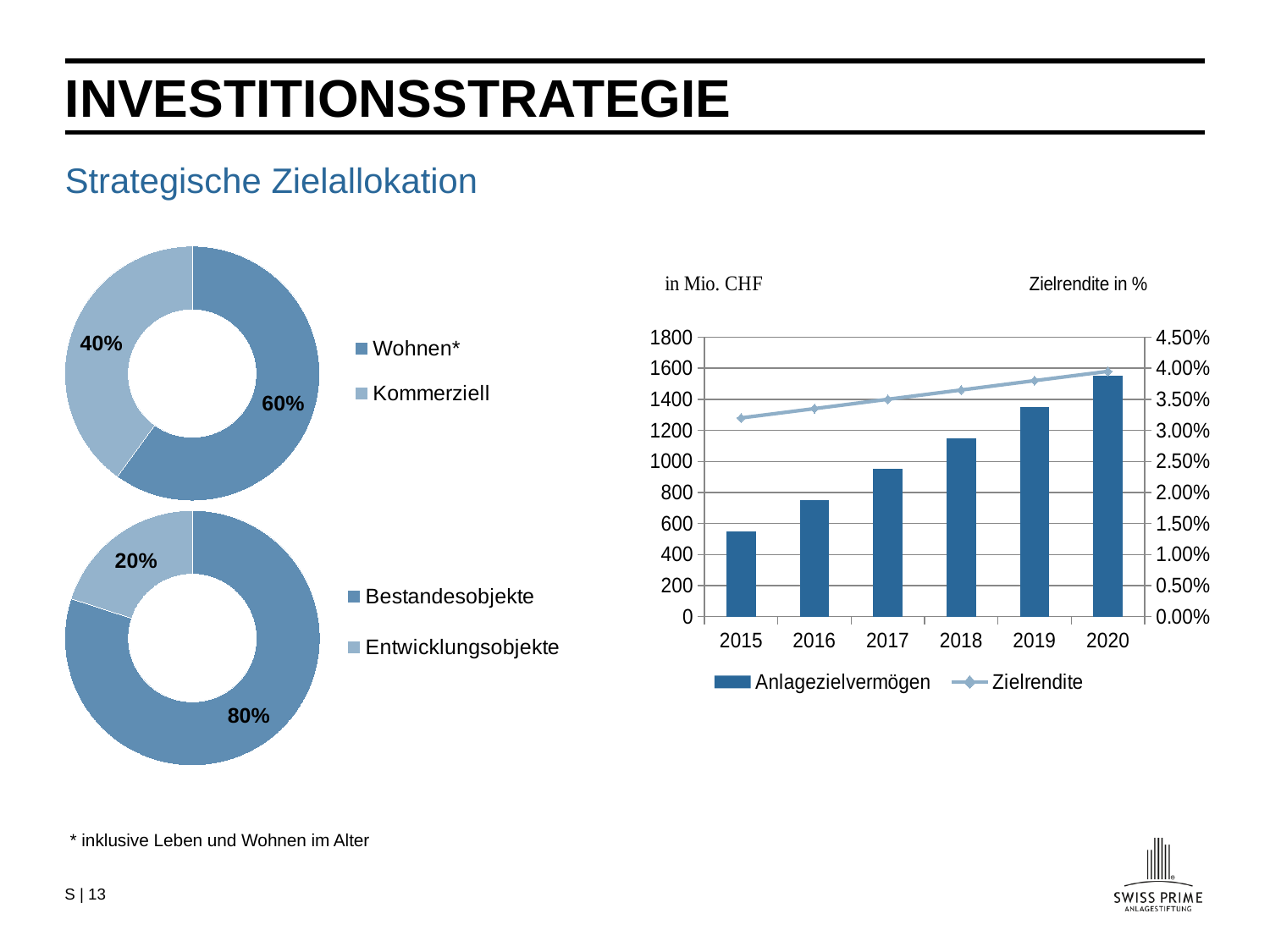
In the top-left donut chart, which category has the larger share, Wohnen* or Kommerziell? Wohnen* In the right-hand chart, how many series does the legend list? 2 In the top-left donut chart, what share is labelled for Kommerziell? 40% In the right-hand chart, do the Anlagezielvermögen bars rise or fall from 2015 to 2020? rise In the top-left donut chart, what share is labelled for Wohnen*? 60% In the right-hand chart, is the Anlagezielvermögen value for 2017 greater or less than 1000? less In the bottom-left donut chart, what is the difference between the Bestandesobjekte share and the Entwicklungsobjekte share? 60% In the bottom-left donut chart, what share is labelled for Entwicklungsobjekte? 20% In the bottom-left donut chart, what share is labelled for Bestandesobjekte? 80% In the right-hand chart, which year has the highest Anlagezielvermögen bar? 2020 In the right-hand chart, how many years are shown on the x axis? 6 In the right-hand chart, is the Anlagezielvermögen value for 2018 greater or less than 1000? greater